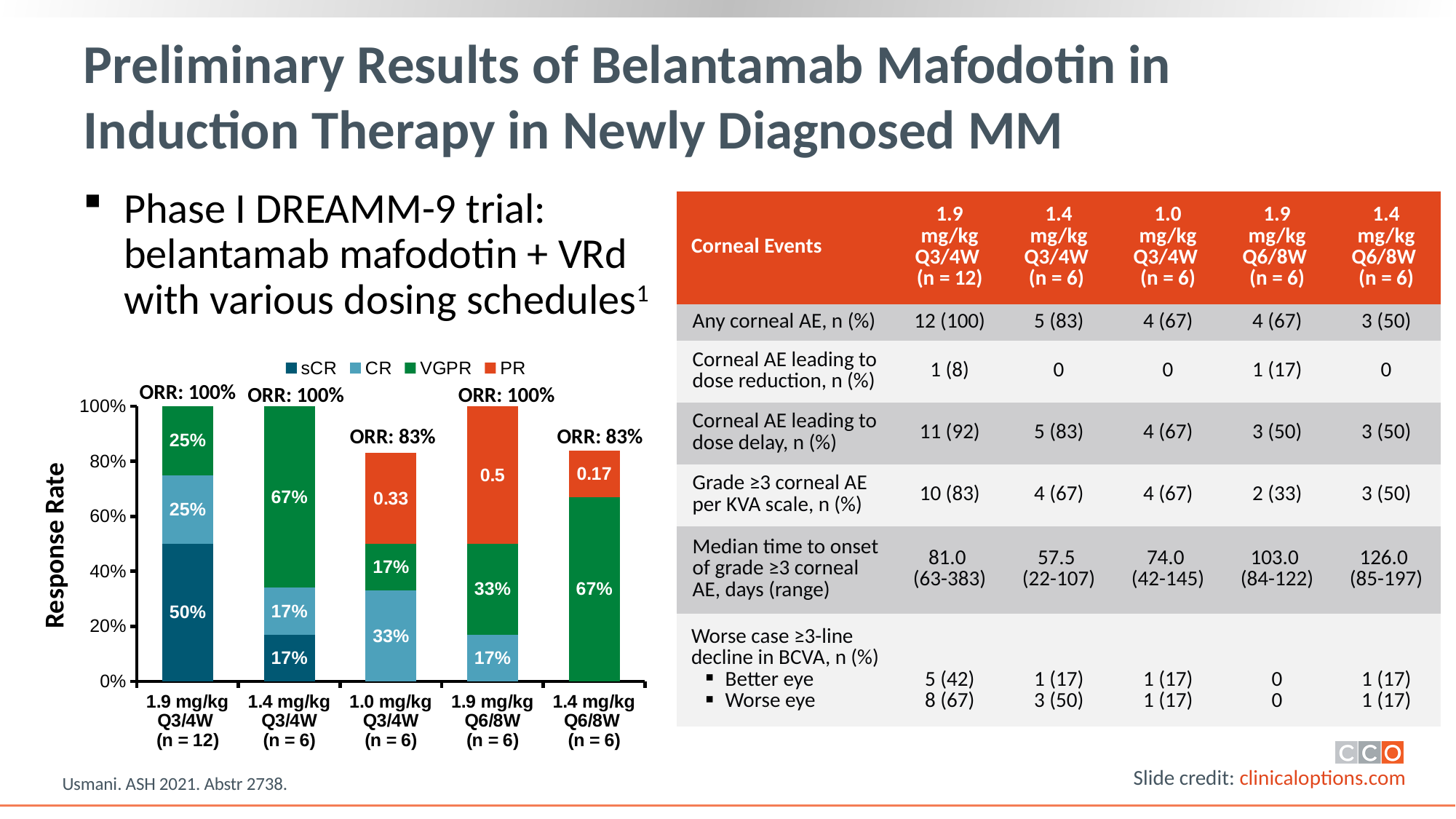
What is the ORR for the 1.0 mg/kg Q3/4W (n = 6) group? 83% What is the difference in sCR rate between the 1.9 mg/kg Q3/4W group and the 1.4 mg/kg Q3/4W group? 33 percentage points Is the total stacked bar for the 1.4 mg/kg Q6/8W group greater or less than 100%? less What is the sCR rate for the 1.9 mg/kg Q3/4W (n = 12) group? 50% Which dosing group has the highest sCR rate? 1.9 mg/kg Q3/4W (n = 12) What is the PR value labelled for the 1.9 mg/kg Q6/8W (n = 6) group? 0.5 What kind of chart is shown on the slide? Stacked bar chart Which group has the larger CR rate: 1.0 mg/kg Q3/4W or 1.9 mg/kg Q6/8W? 1.0 mg/kg Q3/4W How many dosing schedules (categories) are shown on the x axis of the response rate chart? 5 What is the VGPR rate for the 1.4 mg/kg Q3/4W (n = 6) group? 67% How many series does the legend of the response rate chart list? 4 What is the label of the y axis on the response rate chart? Response Rate